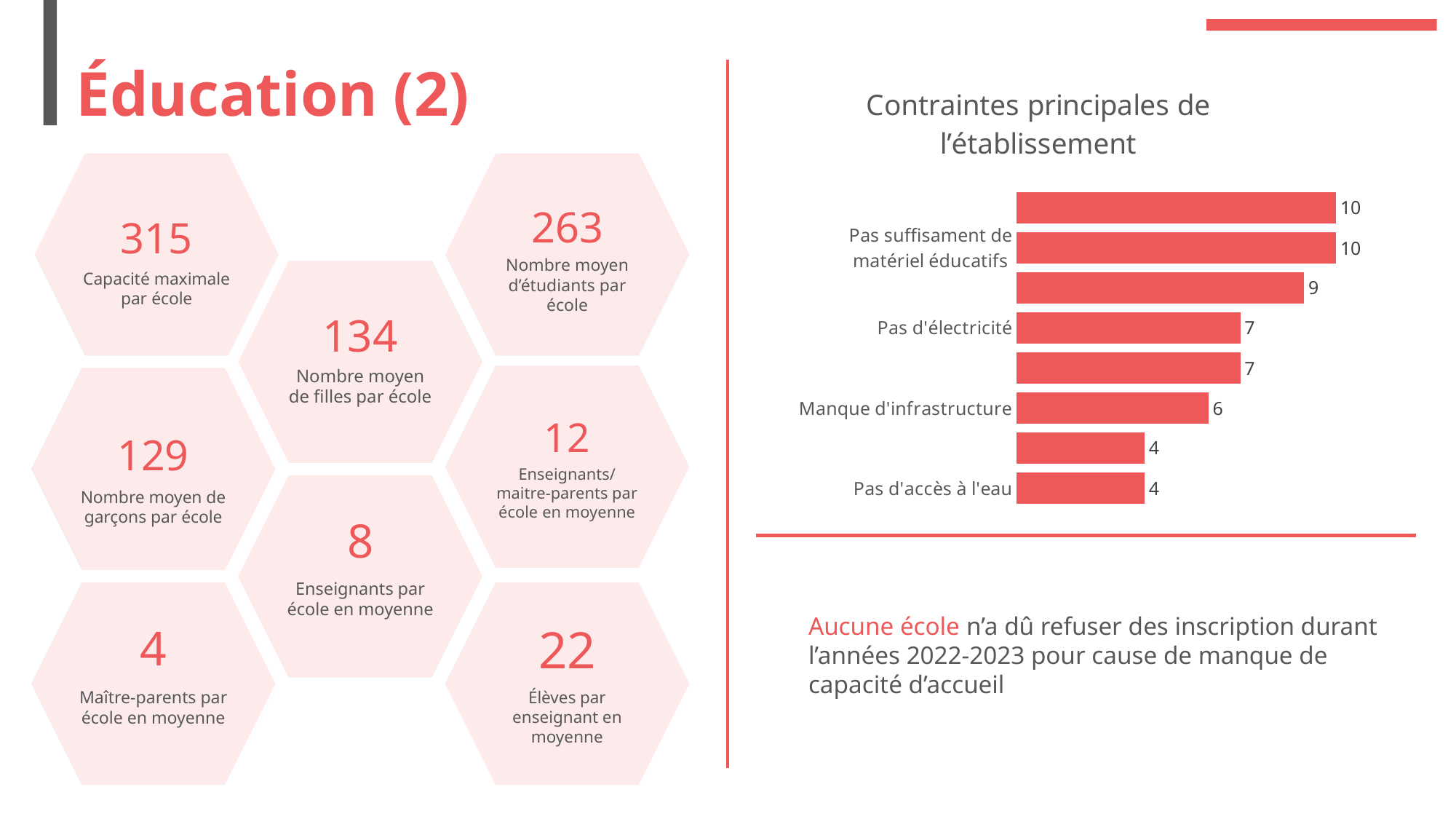
What value is shown for "Pas d'accès à l'eau" in the chart? 4 What is the title of the chart? Contraintes principales de l'établissement What kind of chart is shown on the slide? Bar chart What is the lowest value shown on any bar in the chart? 4 How many bars are plotted in the chart? 8 What value is shown for "Pas d'électricité" in the chart? 7 Which has a larger value, "Pas suffisament de matériel éducatifs" or "Manque d'infrastructure"? Pas suffisament de matériel éducatifs What value is shown for "Manque d'infrastructure" in the chart? 6 What value is shown for "Pas suffisament de matériel éducatifs" in the chart? 10 What is the highest value shown on any bar in the chart? 10 Do the bar values increase or decrease from the top of the chart to the bottom? Decrease What is the difference between the values for "Pas d'électricité" and "Pas d'accès à l'eau"? 3